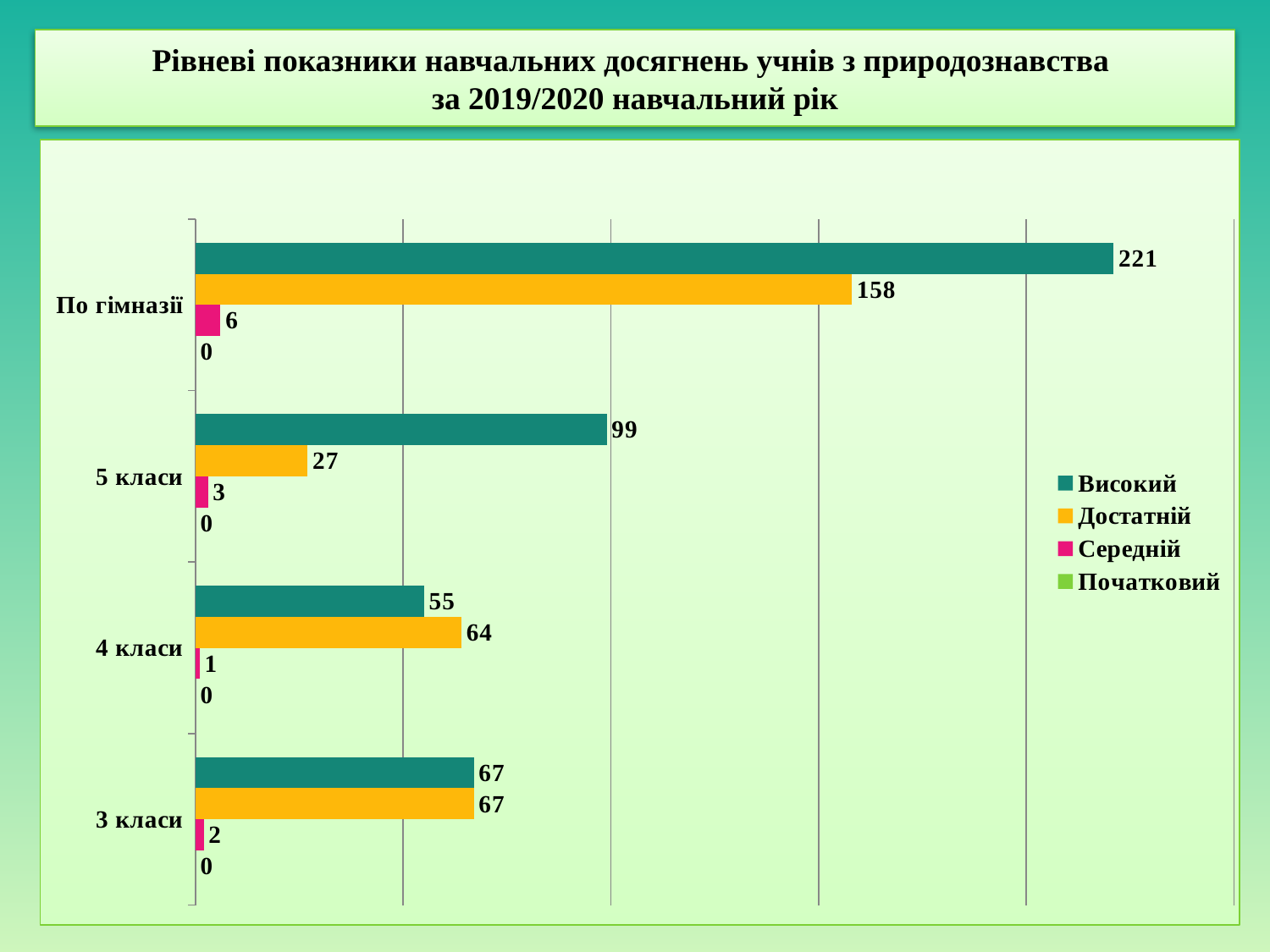
What is the value for Середній in the 4 класи category? 1 Which category has the highest value for Високий? По гімназії Which category has the lowest value for Достатній? 5 класи Which series is shown in pink on the chart? Середній What is the value for Високий in the По гімназії category? 221 What is the value for Достатній in the 5 класи category? 27 What is the difference between Високий and Достатній in the По гімназії category? 63 What is the value for Початковий in the 3 класи category? 0 What kind of chart is shown on the slide? bar chart How many categories are shown on the chart? 4 How many series does the legend list? 4 Which is larger in the 4 класи category, Високий or Достатній? Достатній